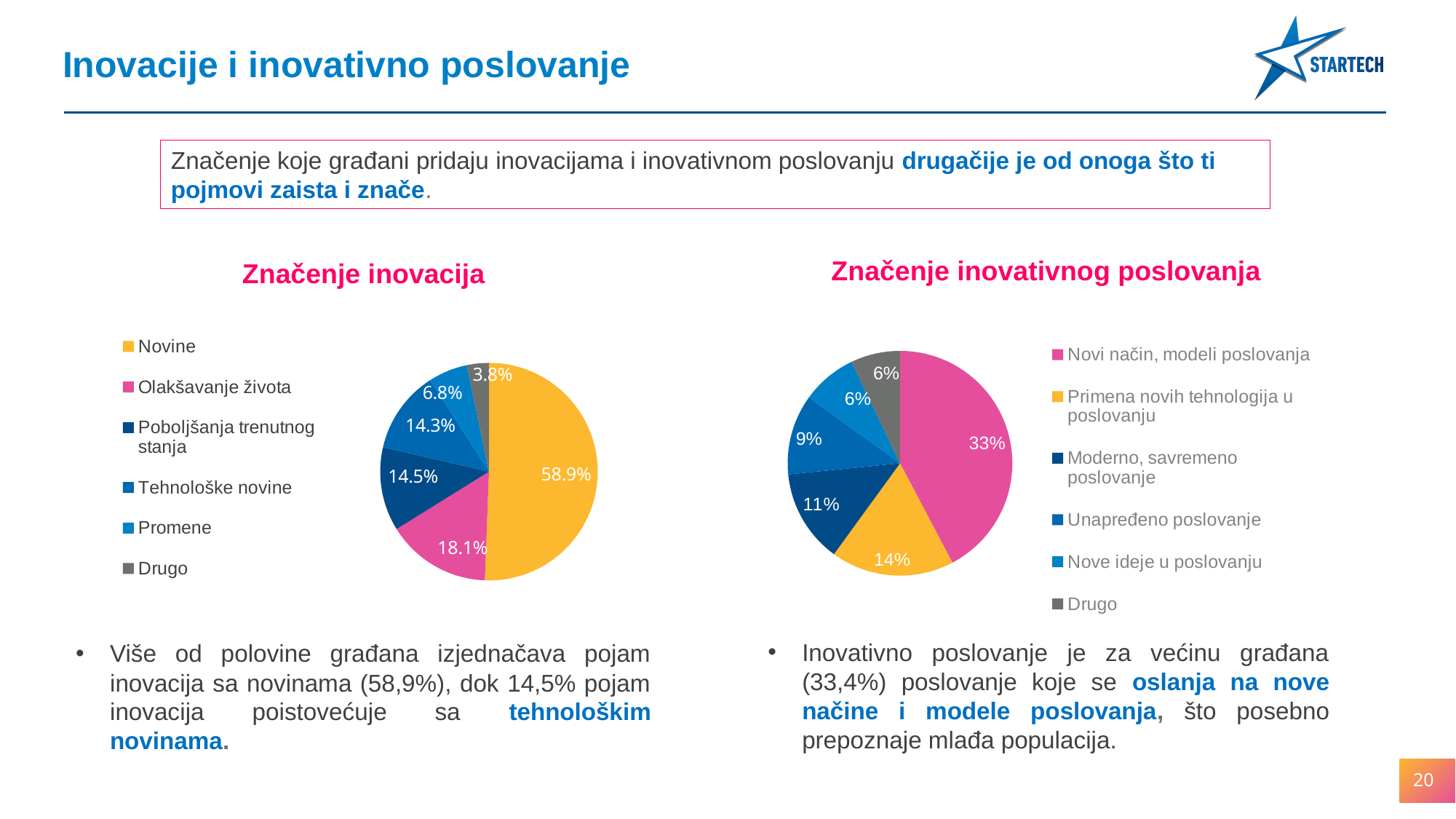
In the "Značenje inovativnog poslovanja" chart, which is larger: Moderno, savremeno poslovanje or Unapređeno poslovanje? Moderno, savremeno poslovanje How many categories does the legend of the "Značenje inovacija" chart list? 6 In the "Značenje inovativnog poslovanja" chart, what share is labelled for Moderno, savremeno poslovanje? 11% In the "Značenje inovativnog poslovanja" chart, what share is labelled for Primena novih tehnologija u poslovanju? 14% What type of chart is used for "Značenje inovacija"? pie chart In the "Značenje inovativnog poslovanja" chart, what is the difference between the shares for Novi način, modeli poslovanja and Primena novih tehnologija u poslovanju? 19% In the "Značenje inovacija" chart, what share is labelled for Drugo? 3.8% In the "Značenje inovacija" chart, what share is labelled for Olakšavanje života? 18.1% In the "Značenje inovacija" chart, what share is labelled for Novine? 58.9% In the "Značenje inovativnog poslovanja" chart, what share is labelled for Novi način, modeli poslovanja? 33% In the "Značenje inovacija" chart, which category has the smallest slice? Drugo In the "Značenje inovacija" chart, which category has the largest slice? Novine